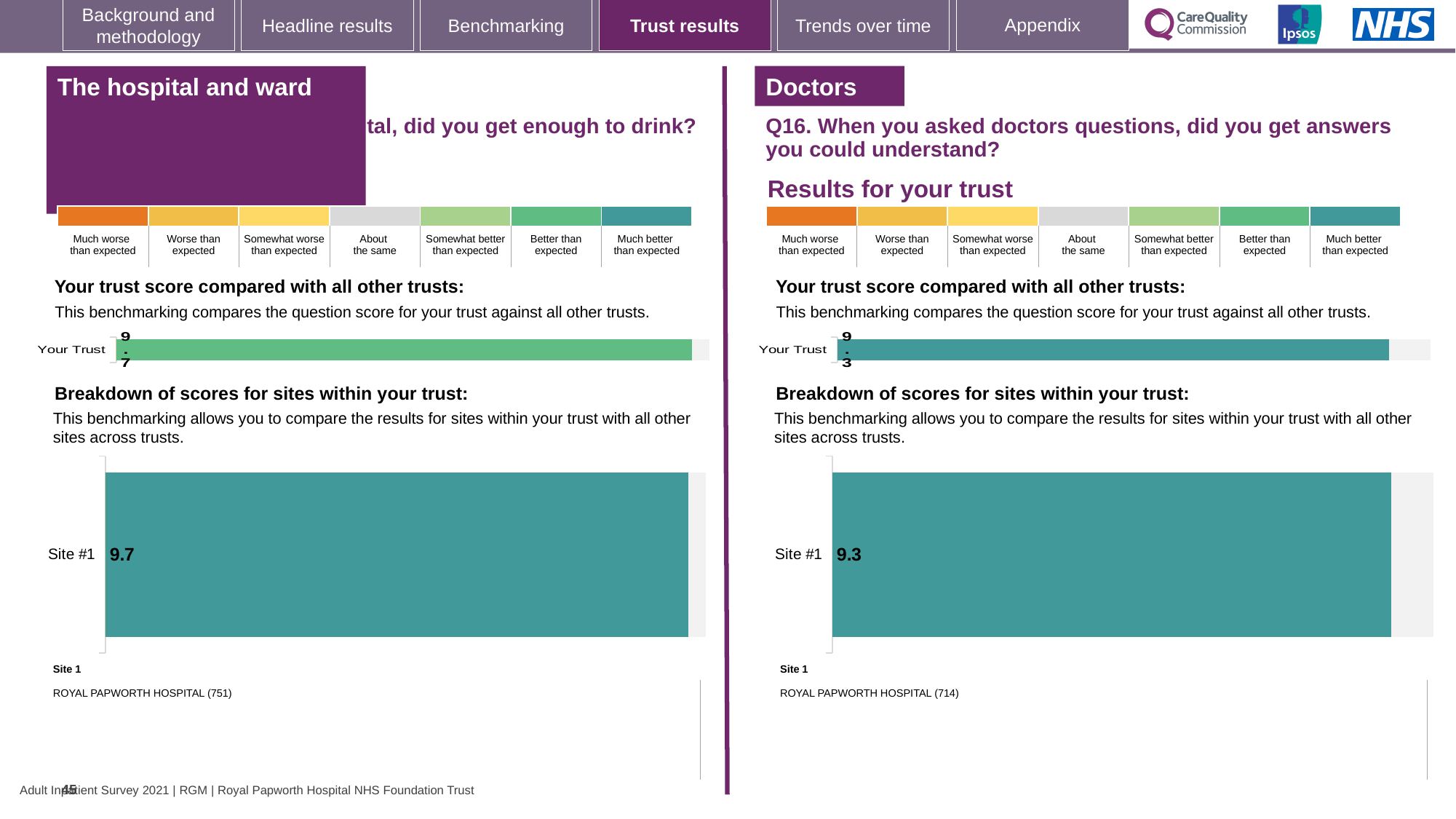
On the left-hand 'Your trust score compared with all other trusts' chart, what is the value shown for Your Trust? 9.7 What is the difference between the Site #1 score on the left-hand site breakdown chart and the Site #1 score on the right-hand site breakdown chart? 0.4 How many sites are shown in the left-hand 'Breakdown of scores for sites within your trust' chart? 1 Comparing the Site #1 scores in the two site breakdown charts, which side of the slide shows the higher score? The left-hand chart (The hospital and ward), 9.7 On the right-hand 'Breakdown of scores for sites within your trust' chart (Doctors, Q16), what is the score for Site #1? 9.3 On the left-hand 'Breakdown of scores for sites within your trust' chart (The hospital and ward), what is the score for Site #1? 9.7 What colour is the Site #1 bar in the right-hand 'Breakdown of scores for sites within your trust' chart? Teal On the left-hand site breakdown chart, which hospital is listed as Site 1 below the chart? ROYAL PAPWORTH HOSPITAL (751) Which of the two 'Your Trust' bars on the slide shows the larger value, the left-hand one or the right-hand one? The left-hand one (9.7) What type of chart is used for the 'Breakdown of scores for sites within your trust' on the right-hand side of the slide? Bar chart On the right-hand 'Your trust score compared with all other trusts' chart (Q16), what is the value shown for Your Trust? 9.3 How many sites are shown in the right-hand 'Breakdown of scores for sites within your trust' chart? 1